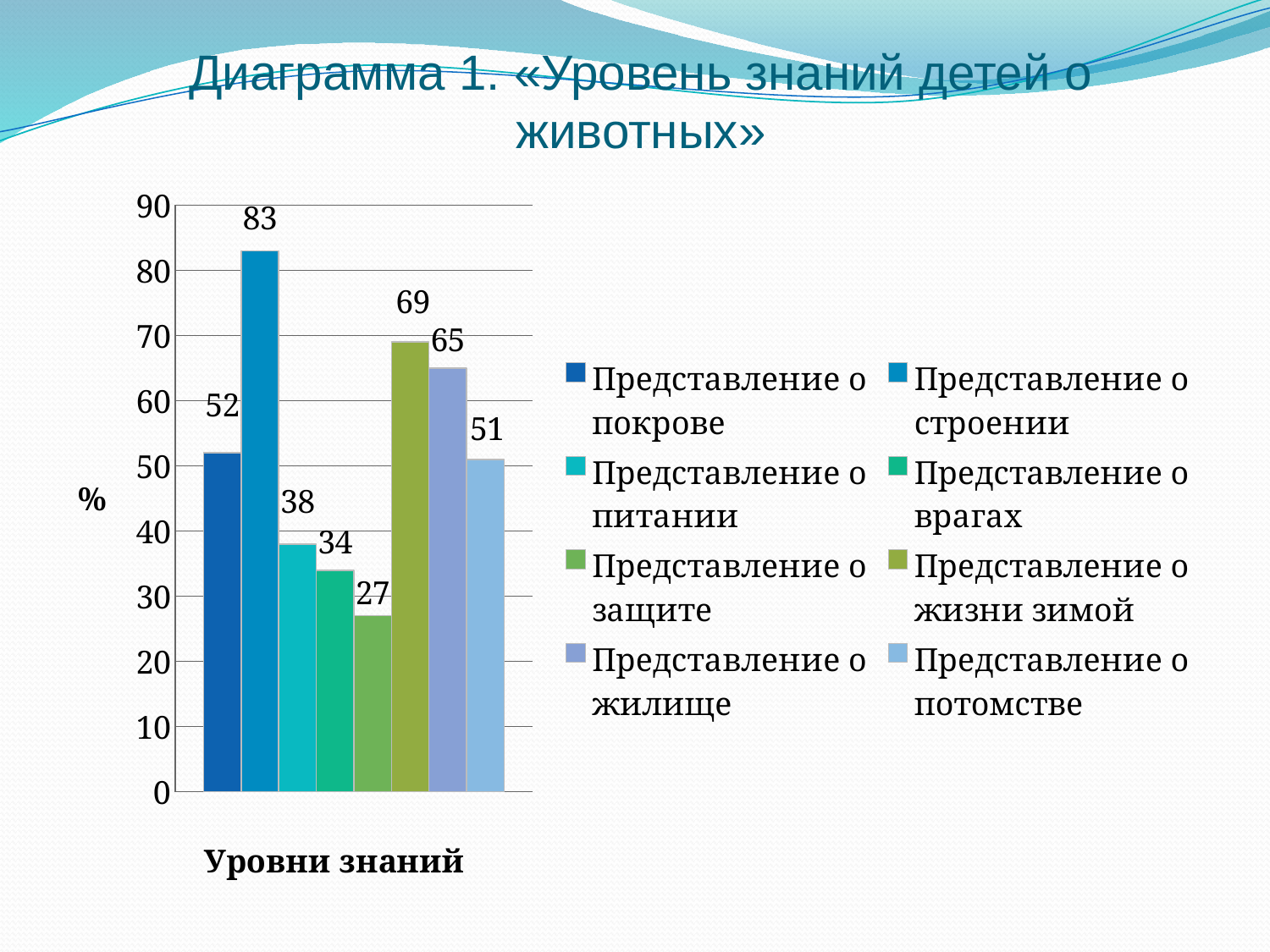
What is the value for «Представление о защите»? 27 What is the value for «Представление о жизни зимой»? 69 What is the difference between the values for «Представление о строении» and «Представление о покрове»? 31 What type of chart is shown on the slide? bar chart What is the value for «Представление о потомстве»? 51 Which series has the lowest value? Представление о защите Which is larger: the value for «Представление о жилище» or «Представление о жизни зимой»? Представление о жизни зимой What is the value for «Представление о строении»? 83 How many series does the legend list? 8 What is the category label shown below the bars? Уровни знаний Which series has the highest value? Представление о строении What is the label on the vertical axis? %